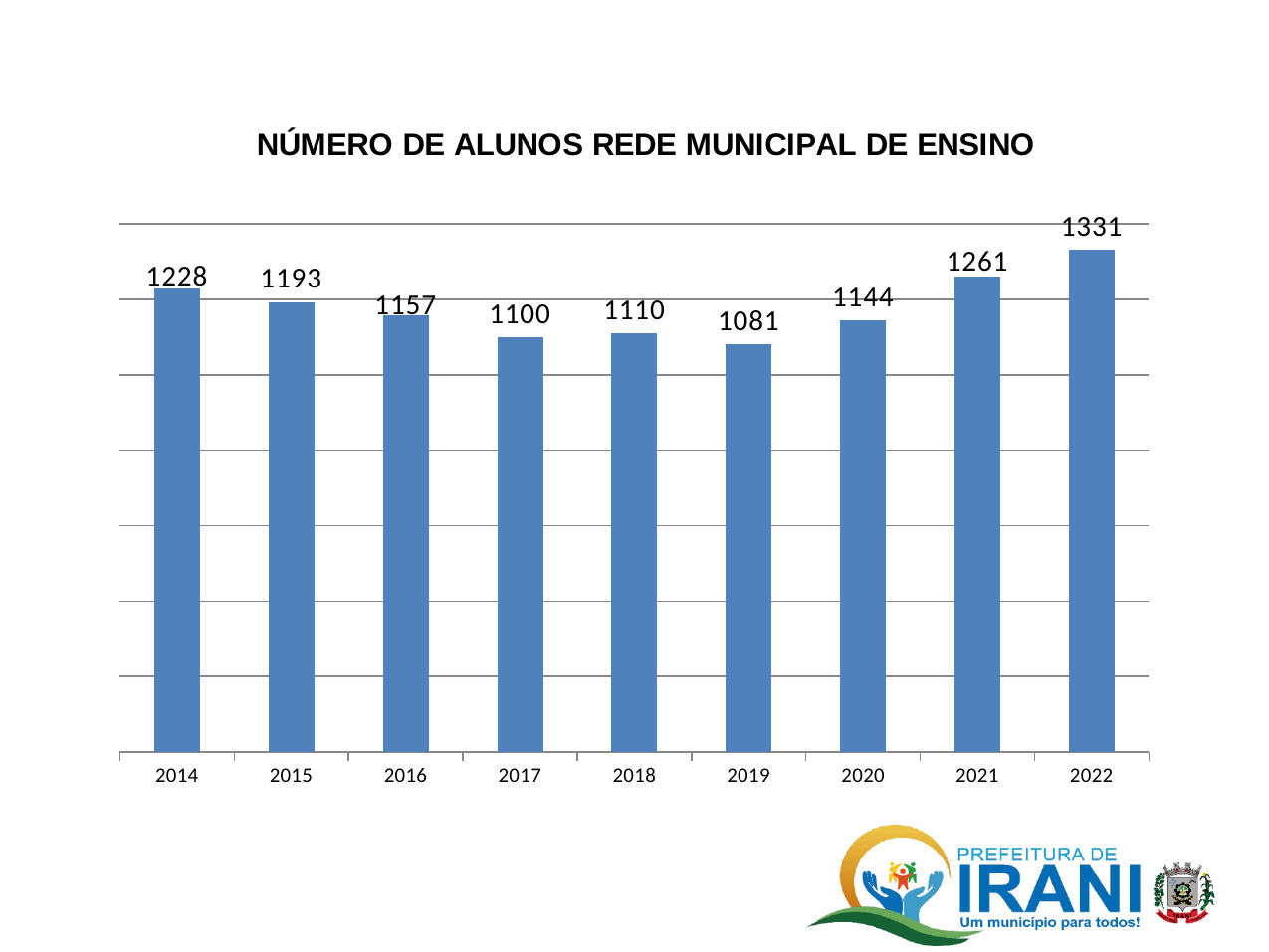
What is the number of students in 2014? 1228 Which year has the highest number of students? 2022 What is the difference between the number of students in 2014 and in 2019? 147 What is the number of students in 2022? 1331 What kind of chart is shown on the slide? Bar chart What is the title of the chart? NÚMERO DE ALUNOS REDE MUNICIPAL DE ENSINO How many years are shown on the x axis? 9 Which year has more students, 2015 or 2020? 2015 What is the difference between the number of students in 2022 and in 2021? 70 Which year has the lowest number of students? 2019 What is the number of students in 2019? 1081 Which year has more students, 2017 or 2018? 2018